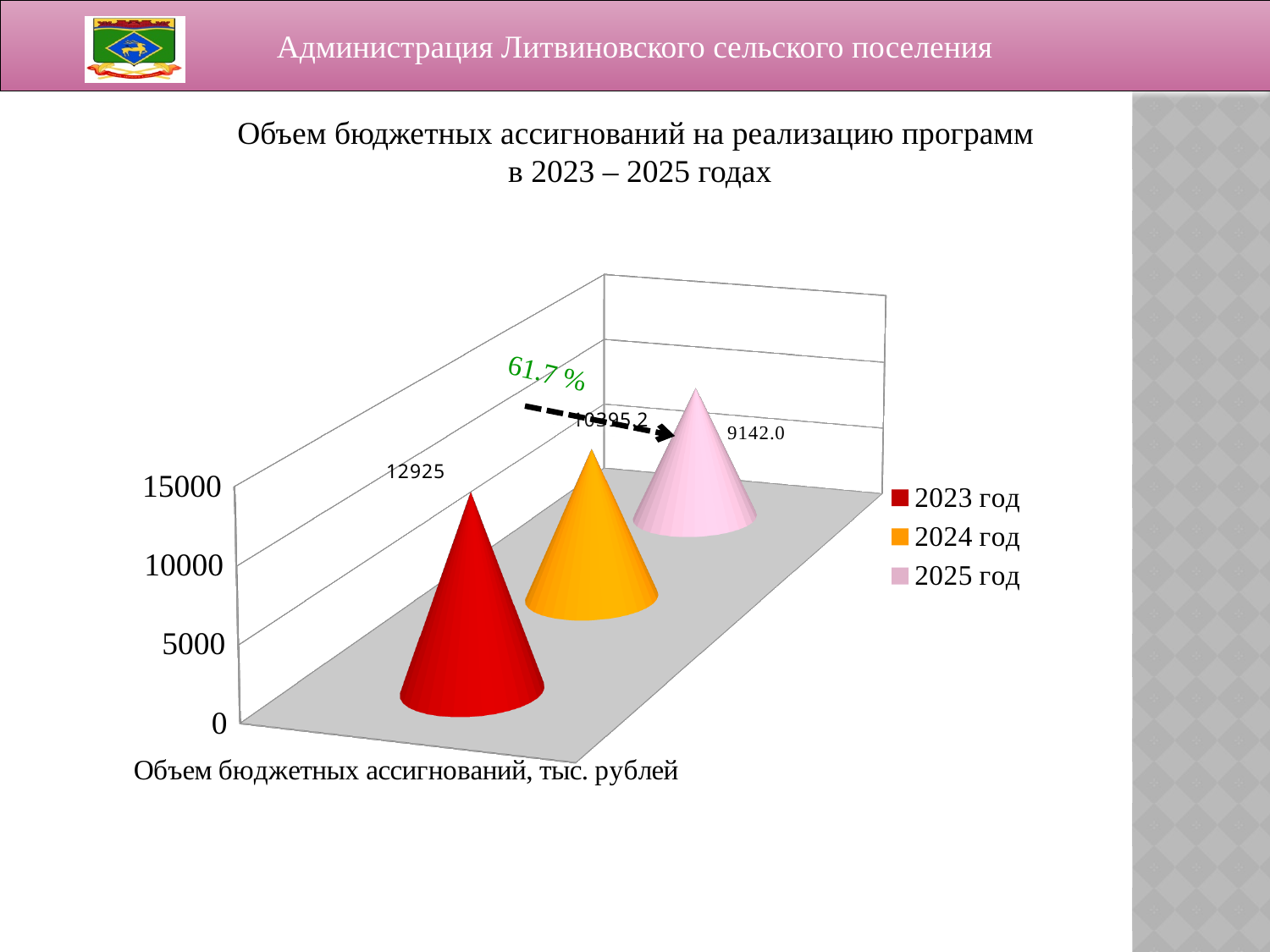
Which year has the lowest value? 2025 год How many series does the legend list? 3 How many years are plotted on the chart? 3 Which is larger, the value for 2023 год or the value for 2024 год? 2023 год What is the value for 2023 год? 12925 Is the value for 2025 год greater or less than 10000? less What unit is given in the axis caption below the chart? тыс. рублей What is the difference between the values for 2023 год and 2025 год? 3783 Is the value for 2024 год greater or less than 10000? greater Which year has the highest value? 2023 год What is the value for 2025 год? 9142.0 Do the values rise or fall from 2023 to 2025? fall